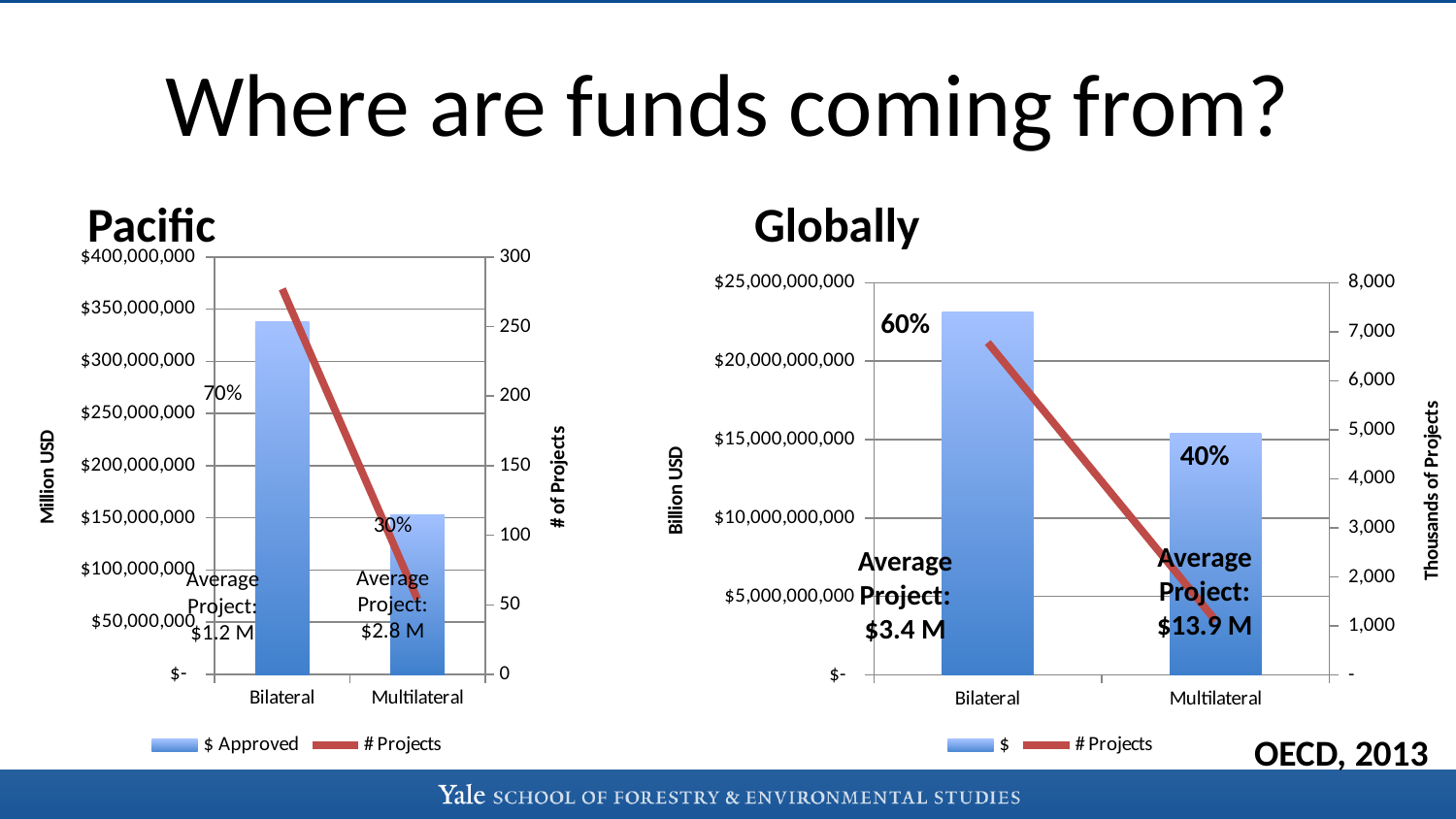
On the Pacific chart, does the # Projects line rise or fall from Bilateral to Multilateral? fall On the Pacific chart, is the # Projects value for Bilateral greater or less than 250? greater On the Pacific chart, what kind of chart is used to show the data? bar chart with a line On the Pacific chart, what percentage label is shown for Bilateral? 70% On the Pacific chart, which category has the higher $ Approved value, Bilateral or Multilateral? Bilateral On the Globally chart, is the $ value for Bilateral greater or less than $20,000,000,000? greater On the Globally chart, how many series does the legend list? 2 On the Pacific chart, is the $ Approved value for Bilateral greater or less than $300,000,000? greater On the Globally chart, what percentage label is shown for Multilateral? 40% On the Pacific chart, what is the average project size shown for Multilateral? $2.8 M On the Globally chart, what is the average project size shown for Bilateral? $3.4 M